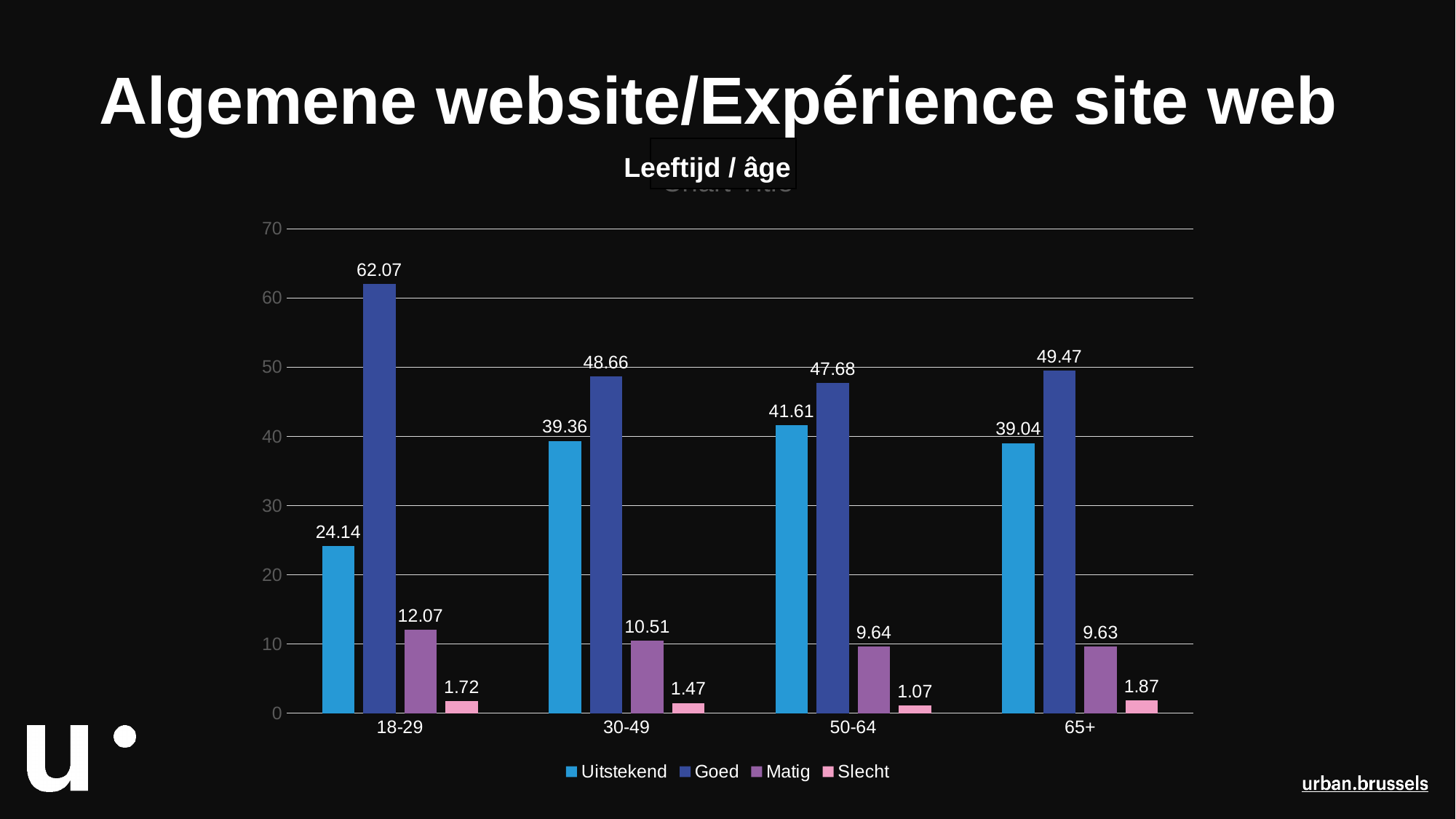
What is the value for Goed in the 18-29 age group? 62.07 Which age group has the lowest value for Uitstekend? 18-29 What is the difference between the Goed and Uitstekend values in the 18-29 age group? 37.93 What is the value for Slecht in the 65+ age group? 1.87 Which is larger in the 65+ age group: Uitstekend or Goed? Goed How many age groups are shown on the x axis? 4 Which series is shown in pink in the legend? Slecht What is the value for Matig in the 30-49 age group? 10.51 What is the value for Uitstekend in the 50-64 age group? 41.61 Which age group has the highest value for Goed? 18-29 What kind of chart is shown on the slide? Bar chart How many series does the legend list? 4